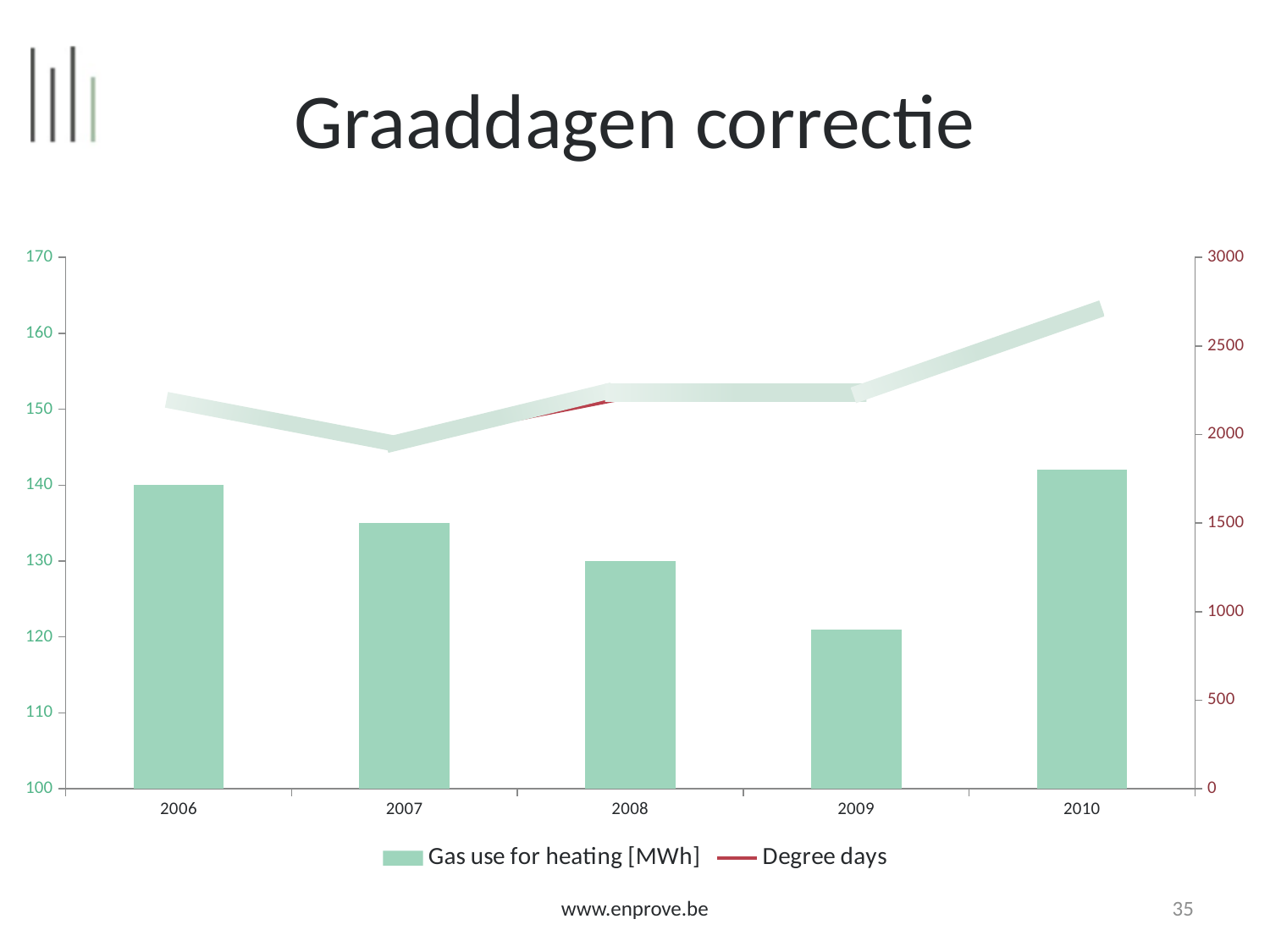
Is the gas use for heating in 2007 greater or less than 140? less What kind of chart is used for the Gas use for heating [MWh] series? Bar chart What is the title of the chart? Graaddagen correctie What is the gas use for heating in 2006? 140 How many years are shown on the x axis? 5 What is the gas use for heating in 2008? 130 Does the gas use for heating rise or fall from 2006 to 2009? fall Which year has the highest gas use for heating? 2010 How many series does the legend list? 2 Which year has the lowest gas use for heating? 2009 Is the gas use for heating in 2009 greater or less than 130? less What are the two series named in the legend? Gas use for heating [MWh] and Degree days